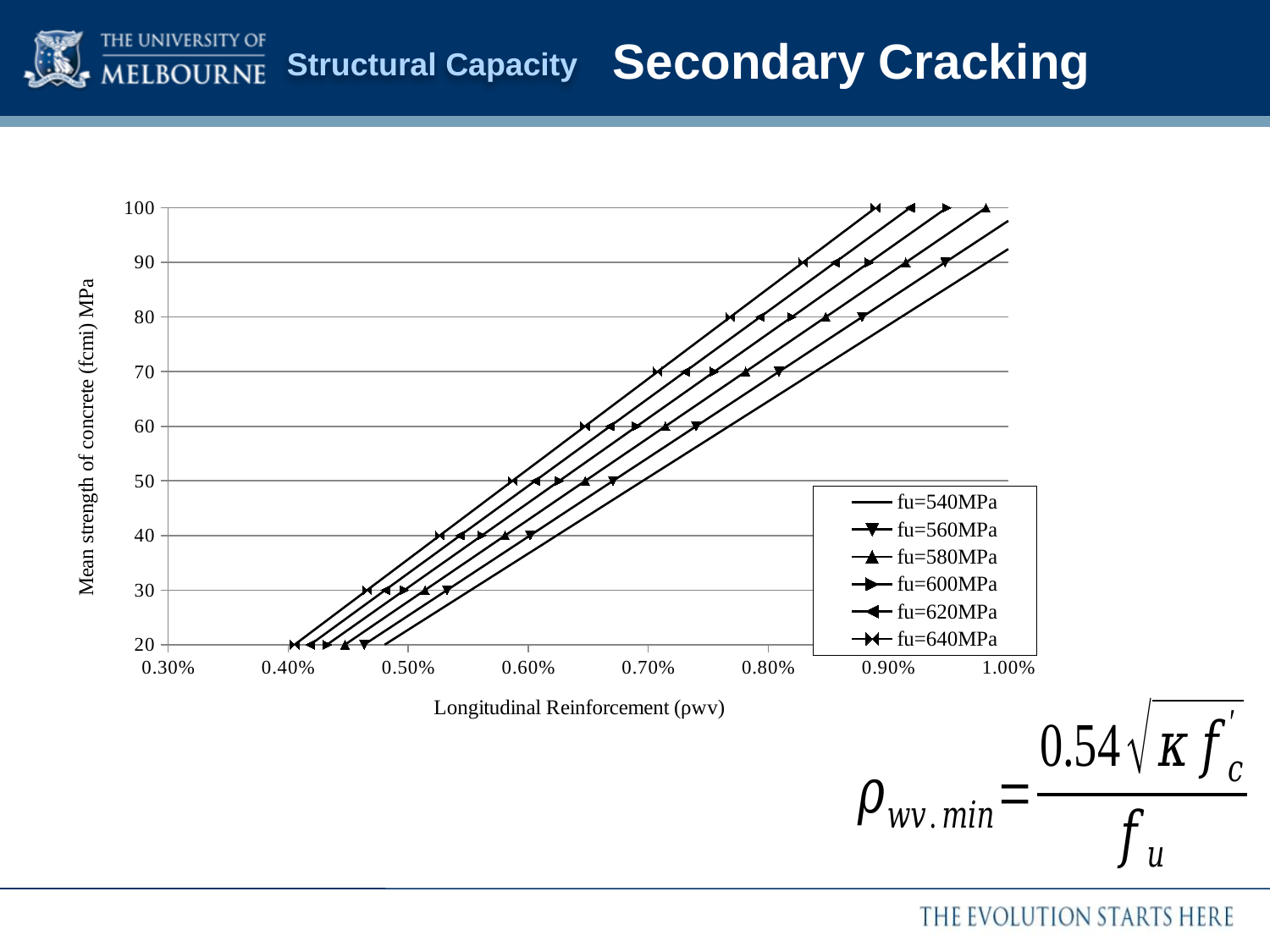
What is the title of the x axis? Longitudinal Reinforcement (ρwv) What is the title of the y axis? Mean strength of concrete (fcmi) MPa Which series requires the highest longitudinal reinforcement at a mean concrete strength of 60 MPa? fu=540MPa How many series does the legend list? 6 What kind of chart is shown on the slide? line chart As the mean strength of concrete increases, does the required longitudinal reinforcement rise or fall for each series? rise At a mean concrete strength of 50 MPa, which series has the larger longitudinal reinforcement, fu=540MPa or fu=640MPa? fu=540MPa Is the longitudinal reinforcement for fu=640MPa at 80 MPa greater or less than 0.80%? less Which series requires the lowest longitudinal reinforcement at a mean concrete strength of 20 MPa? fu=640MPa Is the longitudinal reinforcement for fu=540MPa at 70 MPa greater or less than 0.80%? greater Is the longitudinal reinforcement for fu=540MPa at 30 MPa greater or less than 0.50%? greater